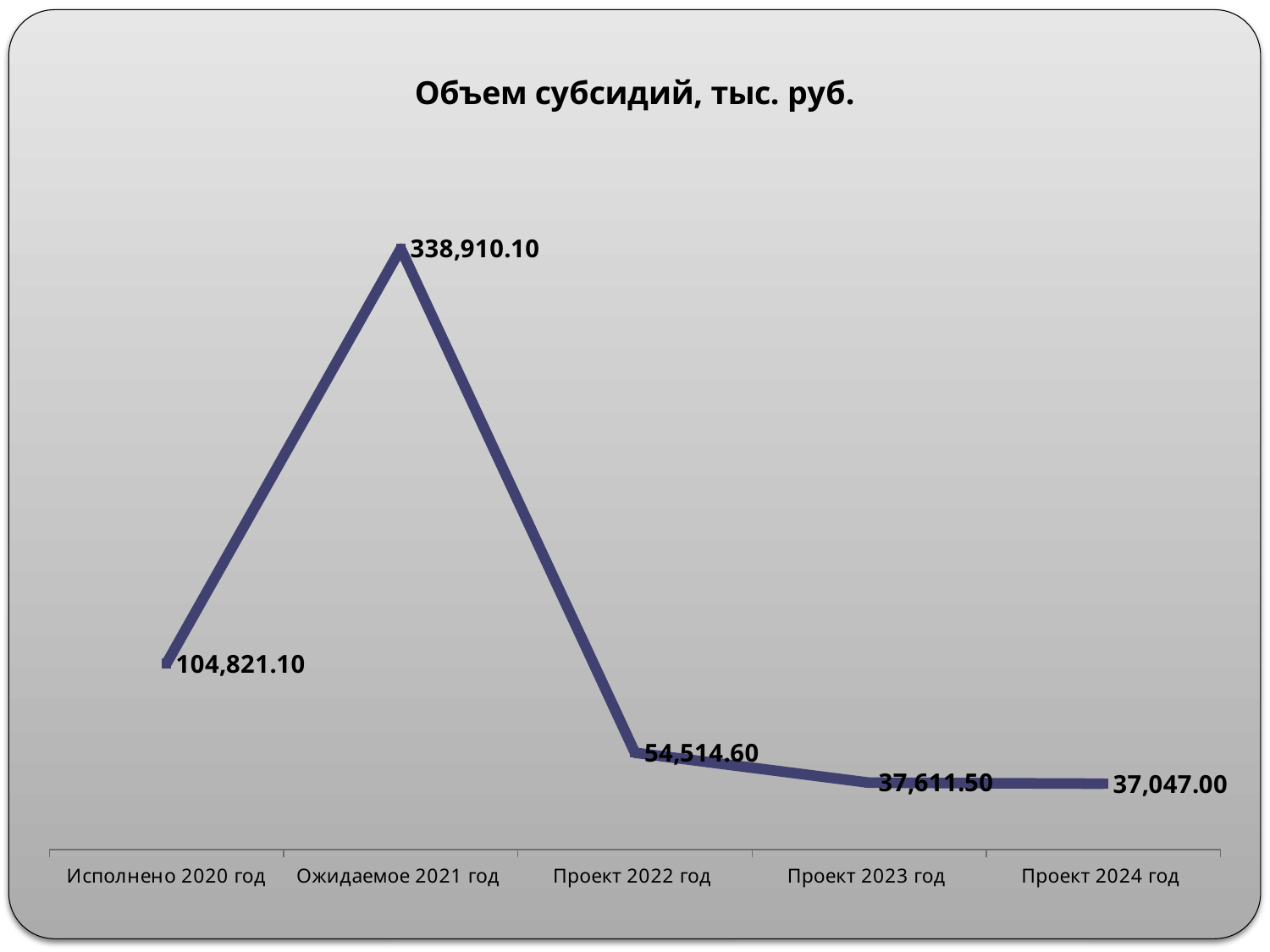
Which category has the highest value? Ожидаемое 2021 год What is the difference between the values for Ожидаемое 2021 год and Исполнено 2020 год? 234,089.00 How many data points are plotted on the chart? 5 Which category has the lowest value? Проект 2024 год What is the value for Ожидаемое 2021 год? 338,910.10 What is the title of the chart? Объем субсидий, тыс. руб. What kind of chart is shown on the slide? Line chart What is the value for Проект 2024 год? 37,047.00 What is the value for Проект 2022 год? 54,514.60 What is the difference between the values for Проект 2022 год and Проект 2023 год? 16,903.10 Which is larger, the value for Исполнено 2020 год or the value for Проект 2022 год? Исполнено 2020 год What is the value for Исполнено 2020 год? 104,821.10